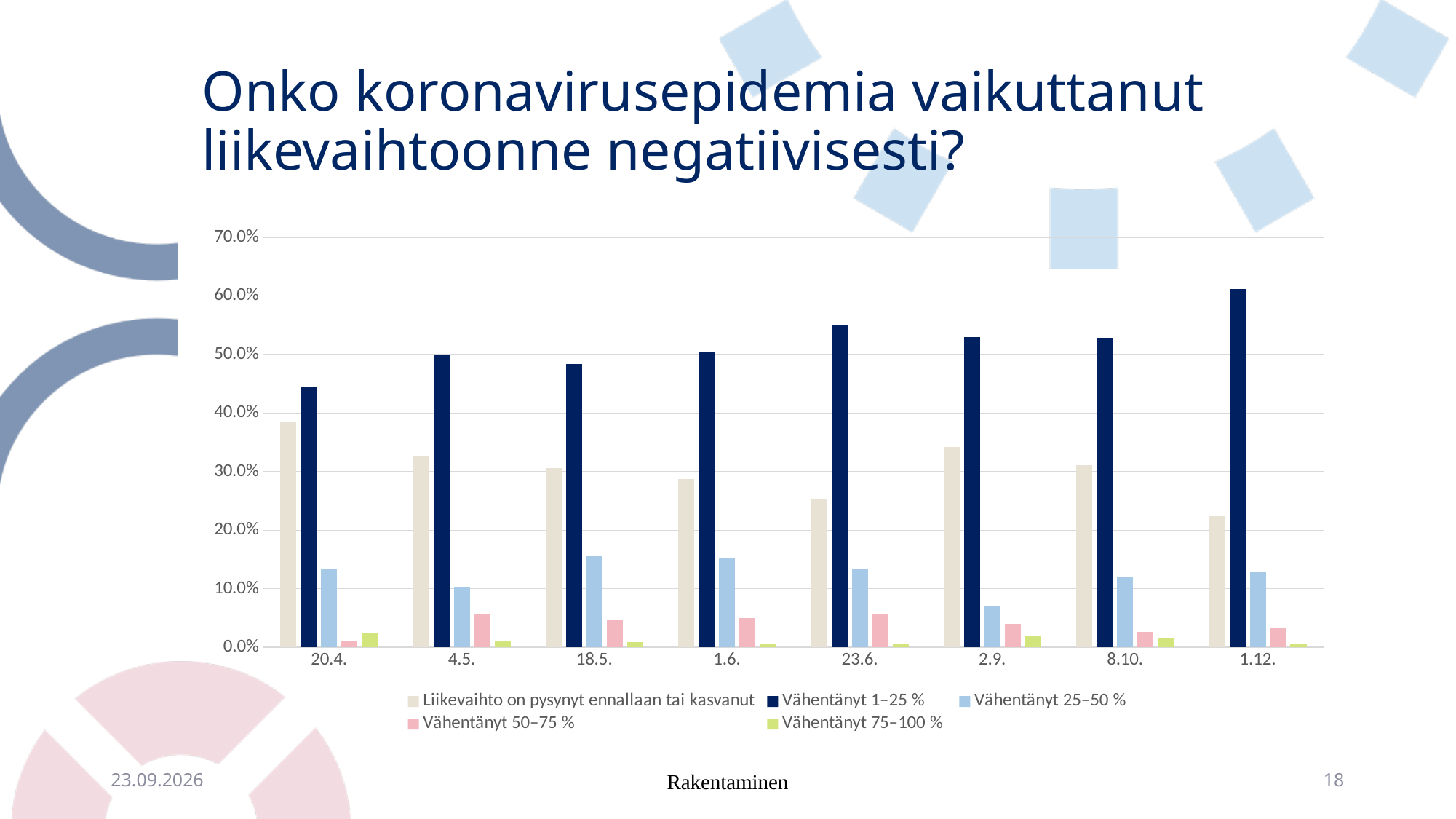
At which date is the value for 'Vähentänyt 1–25 %' lowest? 20.4. Is the value for 'Liikevaihto on pysynyt ennallaan tai kasvanut' at 20.4. greater or less than 30.0%? greater Is the value for 'Vähentänyt 1–25 %' at 1.12. greater or less than 50.0%? greater Is the value for 'Vähentänyt 25–50 %' at 2.9. greater or less than 10.0%? less At 1.12., which is larger: 'Vähentänyt 1–25 %' or 'Liikevaihto on pysynyt ennallaan tai kasvanut'? Vähentänyt 1–25 % What kind of chart is shown on the slide? bar chart At which date is the value for 'Vähentänyt 1–25 %' highest? 1.12. At which date is the value for 'Liikevaihto on pysynyt ennallaan tai kasvanut' highest? 20.4. How many survey dates (categories) are shown on the x axis? 8 At which date is the value for 'Liikevaihto on pysynyt ennallaan tai kasvanut' lowest? 1.12. How many series does the legend list? 5 What is the title of the chart slide? Onko koronavirusepidemia vaikuttanut liikevaihtoonne negatiivisesti?